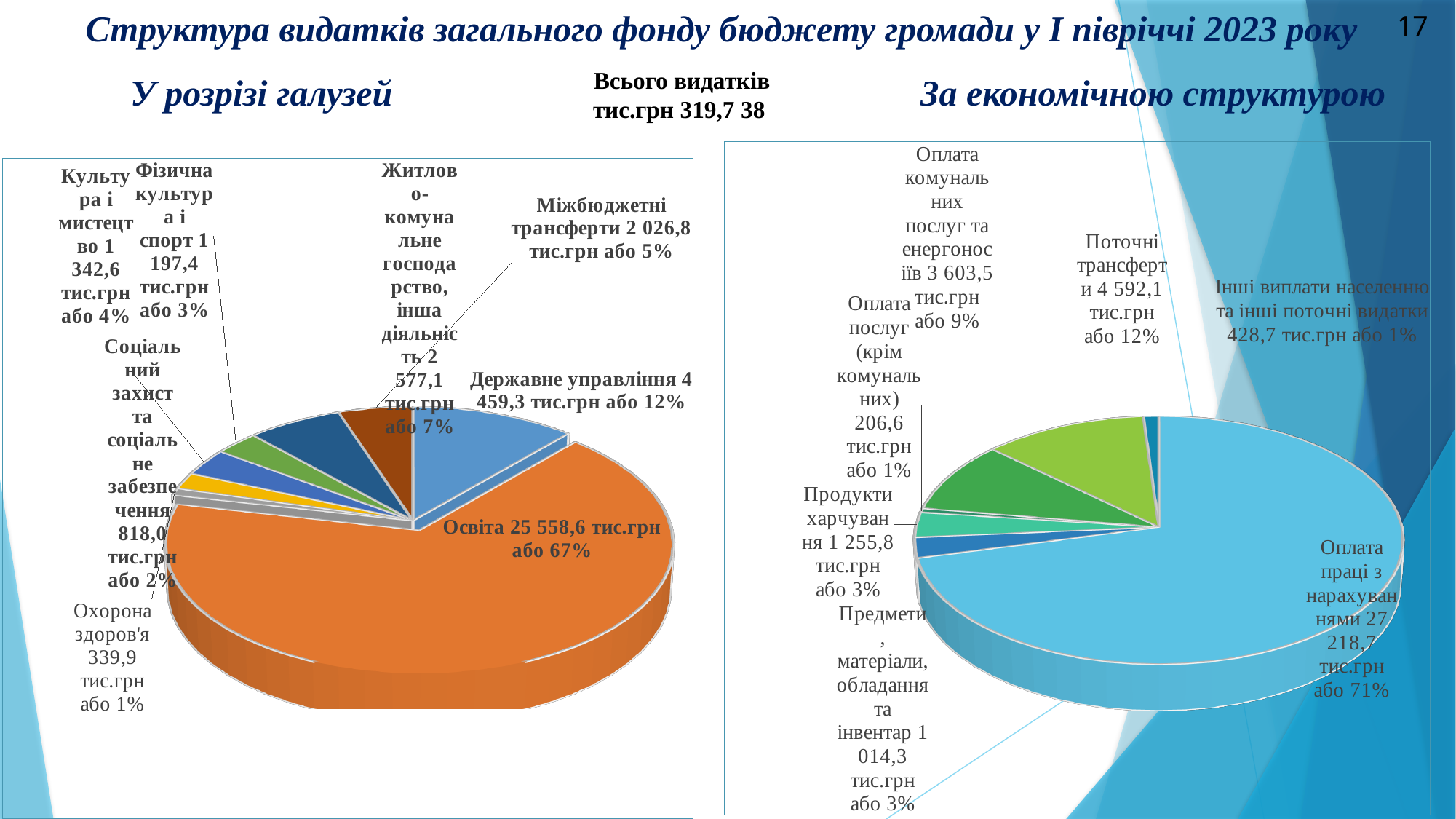
In the left chart "У розрізі галузей", how many categories are shown? 8 In the left chart "У розрізі галузей", what is the value for Освіта? 25 558,6 тис.грн In the right chart "За економічною структурою", what is the difference between Продукти харчування and Предмети, матеріали, обладнання та інвентар? 241,5 тис.грн In the left chart "У розрізі галузей", which category has the smallest value? Охорона здоров'я In the right chart "За економічною структурою", which category has the largest value? Оплата праці з нарахуваннями In the left chart "У розрізі галузей", what share of the pie does Державне управління take? 12% In the left chart "У розрізі галузей", which is larger: Міжбюджетні трансферти or Фізична культура і спорт? Міжбюджетні трансферти In the right chart "За економічною структурою", what is the value for Поточні трансферти? 4 592,1 тис.грн In the right chart "За економічною структурою", what share of the pie does Оплата комунальних послуг та енергоносіїв take? 9% What type of chart is used in the left chart titled "У розрізі галузей"? Pie chart In the left chart "У розрізі галузей", what is the difference between Житлово-комунальне господарство, інша діяльність and Міжбюджетні трансферти? 550,3 тис.грн In the right chart "За економічною структурою", how many categories are shown? 7